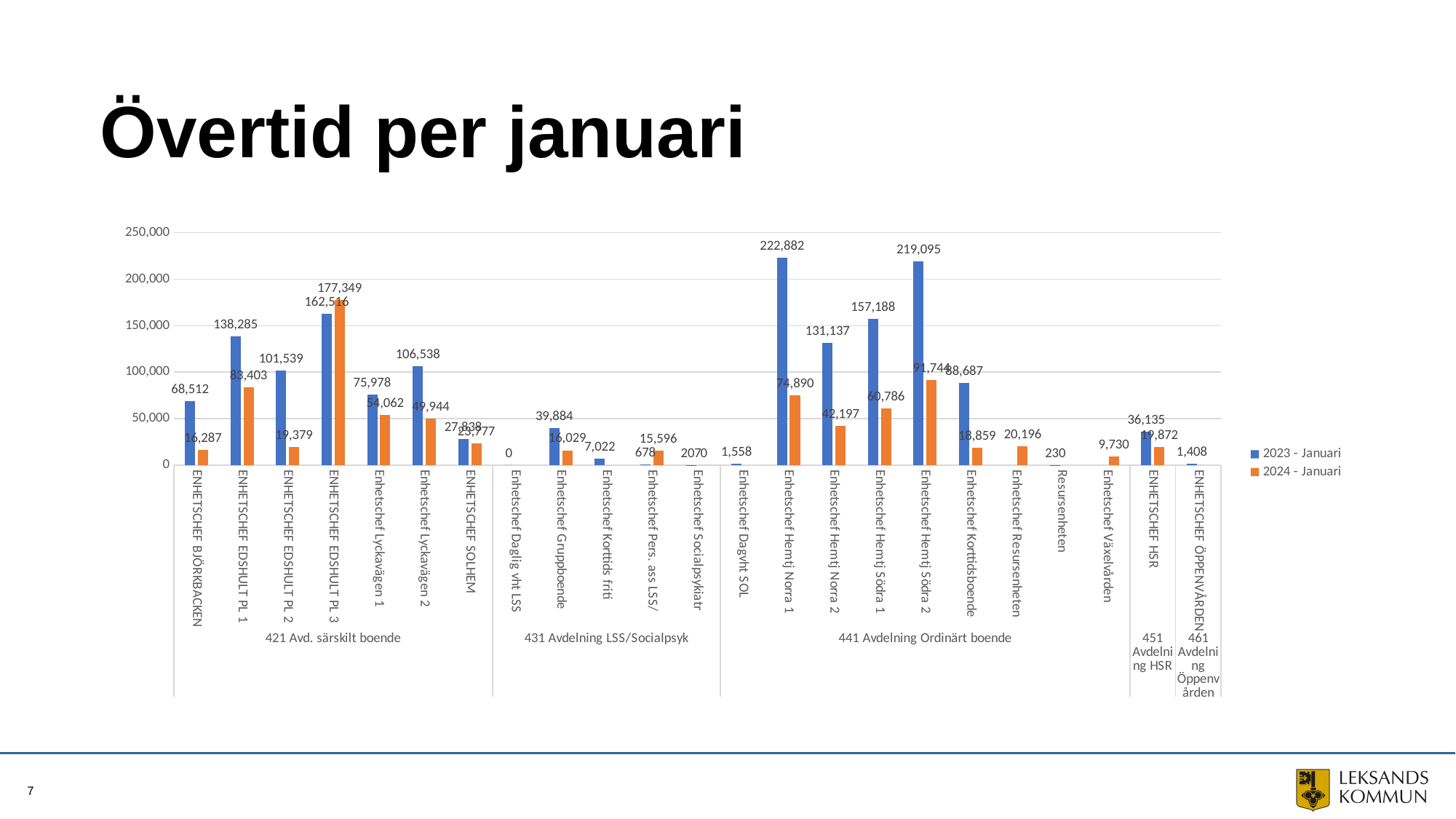
Is the 2023 - Januari value for Enhetschef Hemtj Södra 1 greater or less than 150,000? greater What is the 2024 - Januari value for Enhetschef Hemtj Södra 2? 91,744 Which is larger for ENHETSCHEF EDSHULT PL 3: the 2023 - Januari value or the 2024 - Januari value? 2024 - Januari Which category has the highest 2024 - Januari value? ENHETSCHEF EDSHULT PL 3 What kind of chart is shown on the slide? Bar chart What is the 2024 - Januari value for ENHETSCHEF EDSHULT PL 3? 177,349 Which category has the highest 2023 - Januari value? Enhetschef Hemtj Norra 1 Which colour represents the 2024 - Januari series? Orange What is the title of the slide? Övertid per januari What is the 2023 - Januari value for Enhetschef Hemtj Norra 1? 222,882 How many series does the legend list? 2 What is the difference between the 2023 - Januari and 2024 - Januari values for ENHETSCHEF EDSHULT PL 1? 54,882